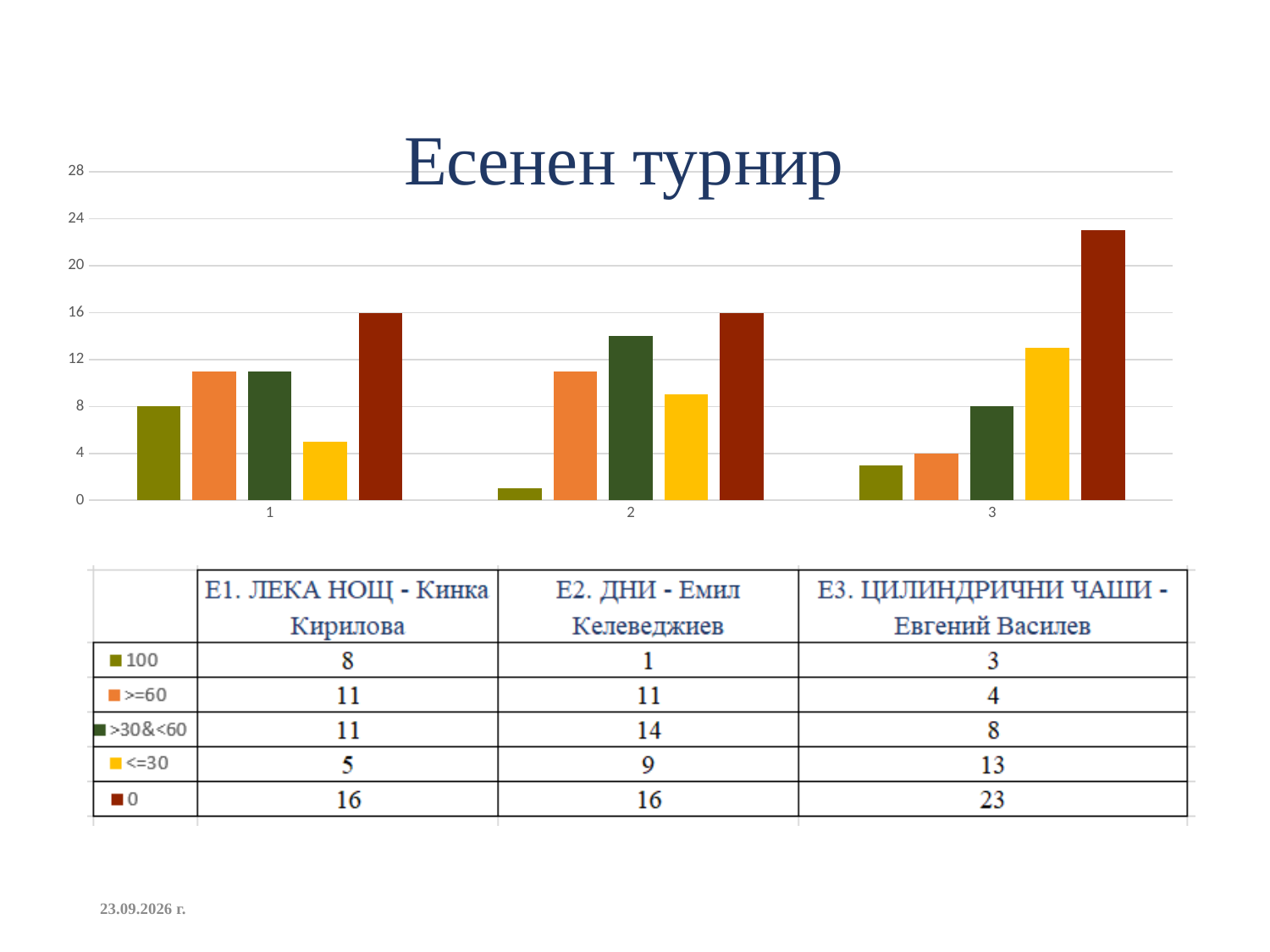
How many categories are shown on the x axis of the chart? 3 What is the value of the '>30&<60' series for category 2 (Е2. ДНИ)? 14 Which category has the highest value in the '0' series? 3 What is the value of the '0' series for category 3 (Е3. ЦИЛИНДРИЧНИ ЧАШИ)? 23 What kind of chart is shown on the slide? bar chart What is the difference between the '<=30' values for category 3 and category 1? 8 How many series does the data table legend list? 5 Which is larger: the '>=60' value for category 1 or the '>=60' value for category 3? category 1 Which category has the lowest value in the '100' series? 2 What is the title of the chart? Есенен турнир What is the value of the '100' series for category 1 (Е1. ЛЕКА НОЩ)? 8 Is the value of the '0' series for category 3 greater or less than 20? greater